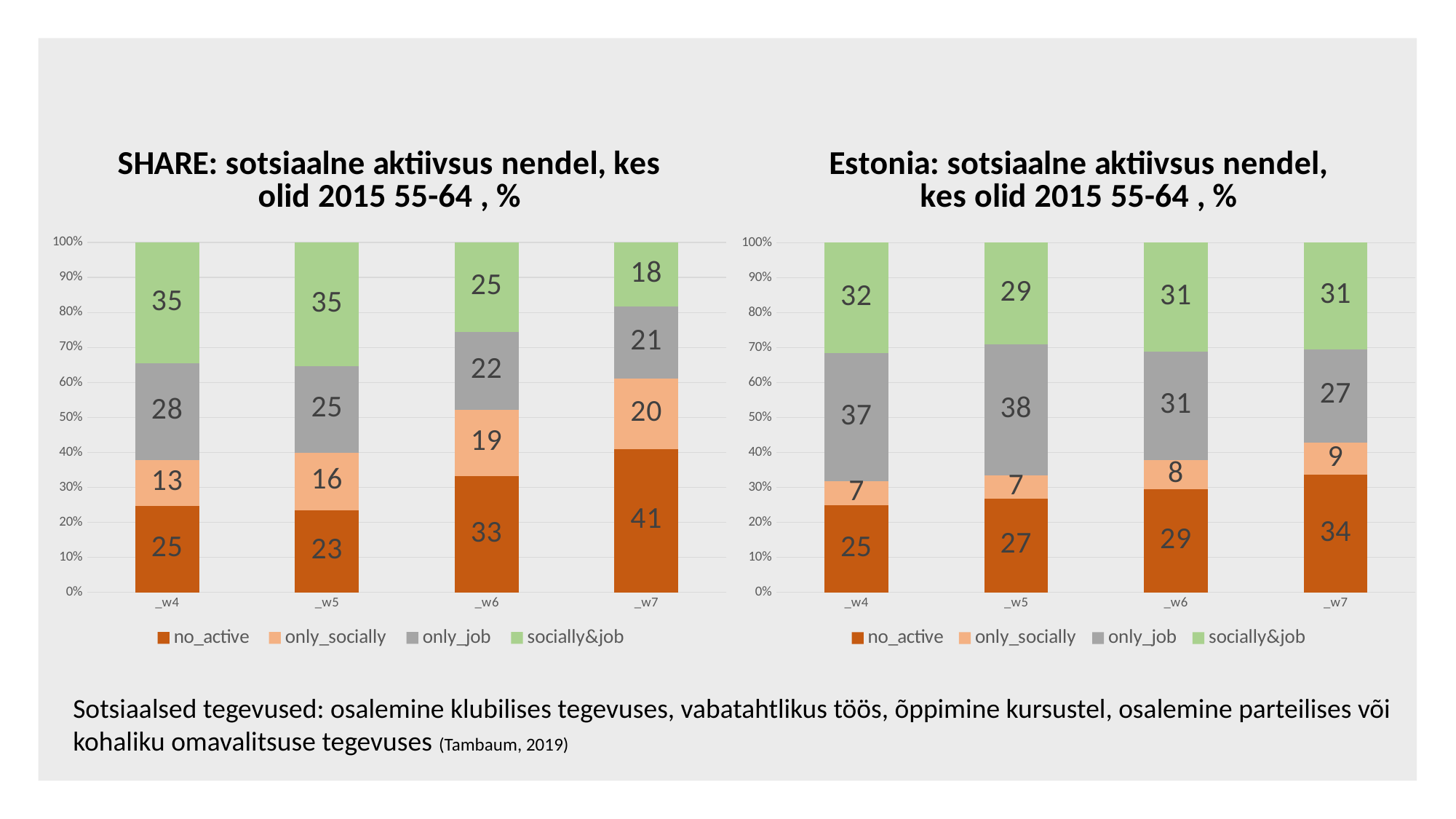
What kind of chart is the SHARE chart on the left? Stacked bar chart In the SHARE chart on the left, what is the value of no_active for _w7? 41 In the SHARE chart on the left, which category has the highest no_active value? _w7 In the Estonia chart on the right, does the no_active value rise or fall from _w4 to _w7? Rise How many series does the legend of the Estonia chart on the right list? 4 In the Estonia chart on the right, which category has the lowest only_job value? _w7 In the Estonia chart on the right, which is larger: the no_active value for _w6 or the only_job value for _w6? only_job In the SHARE chart on the left, what is the difference between the socially&job values for _w4 and _w7? 17 In the SHARE chart on the left, what is the value of socially&job for _w6? 25 In the Estonia chart on the right, what is the value of only_job for _w5? 38 How many categories are shown on the x axis of the SHARE chart on the left? 4 In the Estonia chart on the right, what is the value of only_socially for _w7? 9